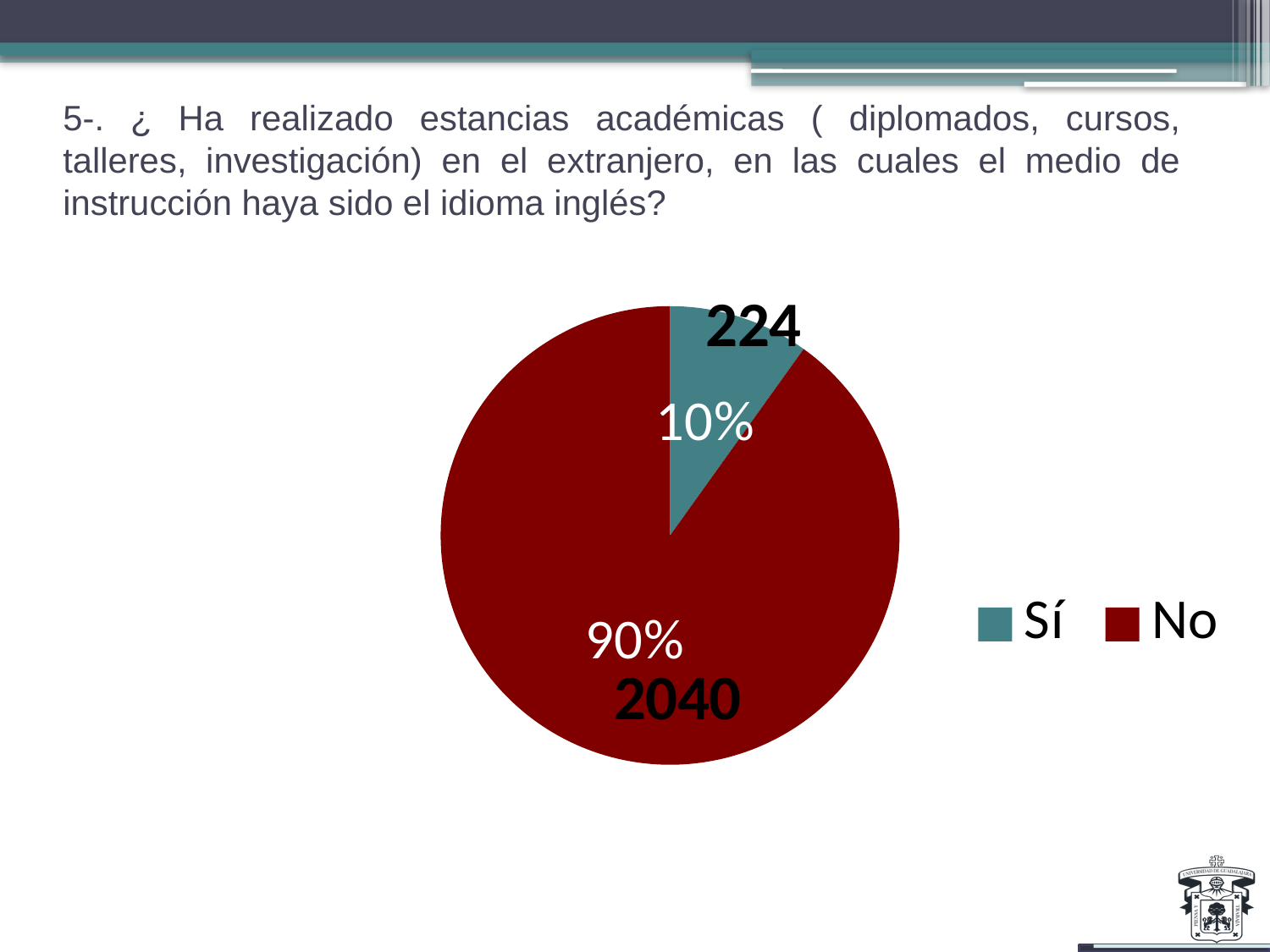
What is the difference between the counts for "No" and "Sí"? 1816 What is the count shown for the "Sí" slice? 224 How many categories does the legend list? 2 Which category has the largest slice of the pie? No What colour is the "No" slice of the pie? dark red Which category has the smallest slice of the pie? Sí What is the count shown for the "No" slice? 2040 Which is larger, the count for "Sí" or the count for "No"? No What is the total of the counts for "Sí" and "No"? 2264 What percentage of the pie corresponds to "No"? 90% What percentage of the pie corresponds to "Sí"? 10% What kind of chart is shown on the slide? pie chart